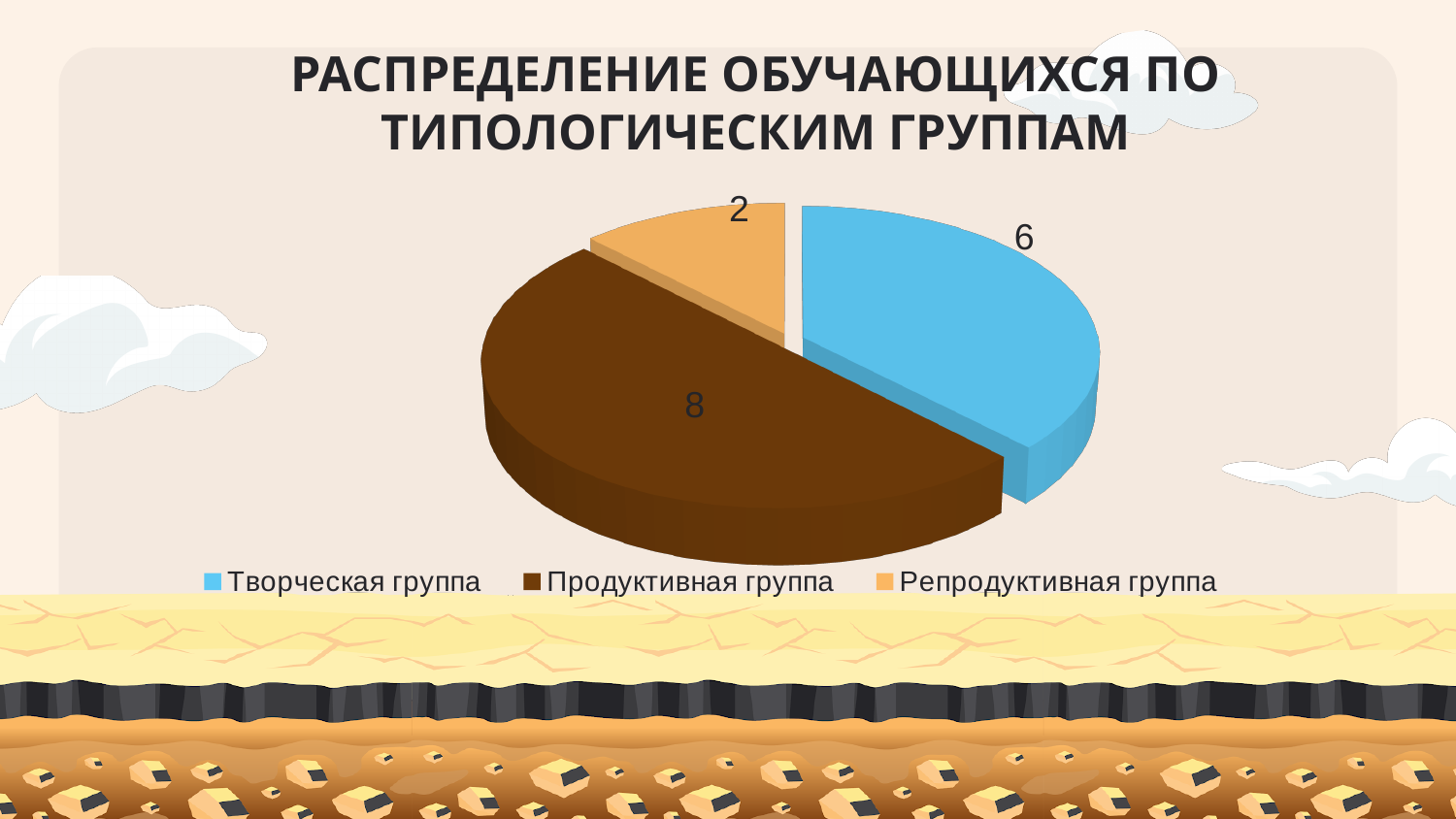
What is the difference between the values for Творческая группа and Репродуктивная группа? 4 What is the title of the chart? РАСПРЕДЕЛЕНИЕ ОБУЧАЮЩИХСЯ ПО ТИПОЛОГИЧЕСКИМ ГРУППАМ What is the difference between the values for Продуктивная группа and Творческая группа? 2 What is the value for Репродуктивная группа? 2 What is the value for Продуктивная группа? 8 Which is larger, the value for Творческая группа or the value for Репродуктивная группа? Творческая группа How many categories does the pie chart have? 3 What share of the pie does Продуктивная группа represent? 50% Which group has the largest slice of the pie? Продуктивная группа What type of chart is shown on the slide? Pie chart Which group has the smallest slice of the pie? Репродуктивная группа What is the value for Творческая группа? 6